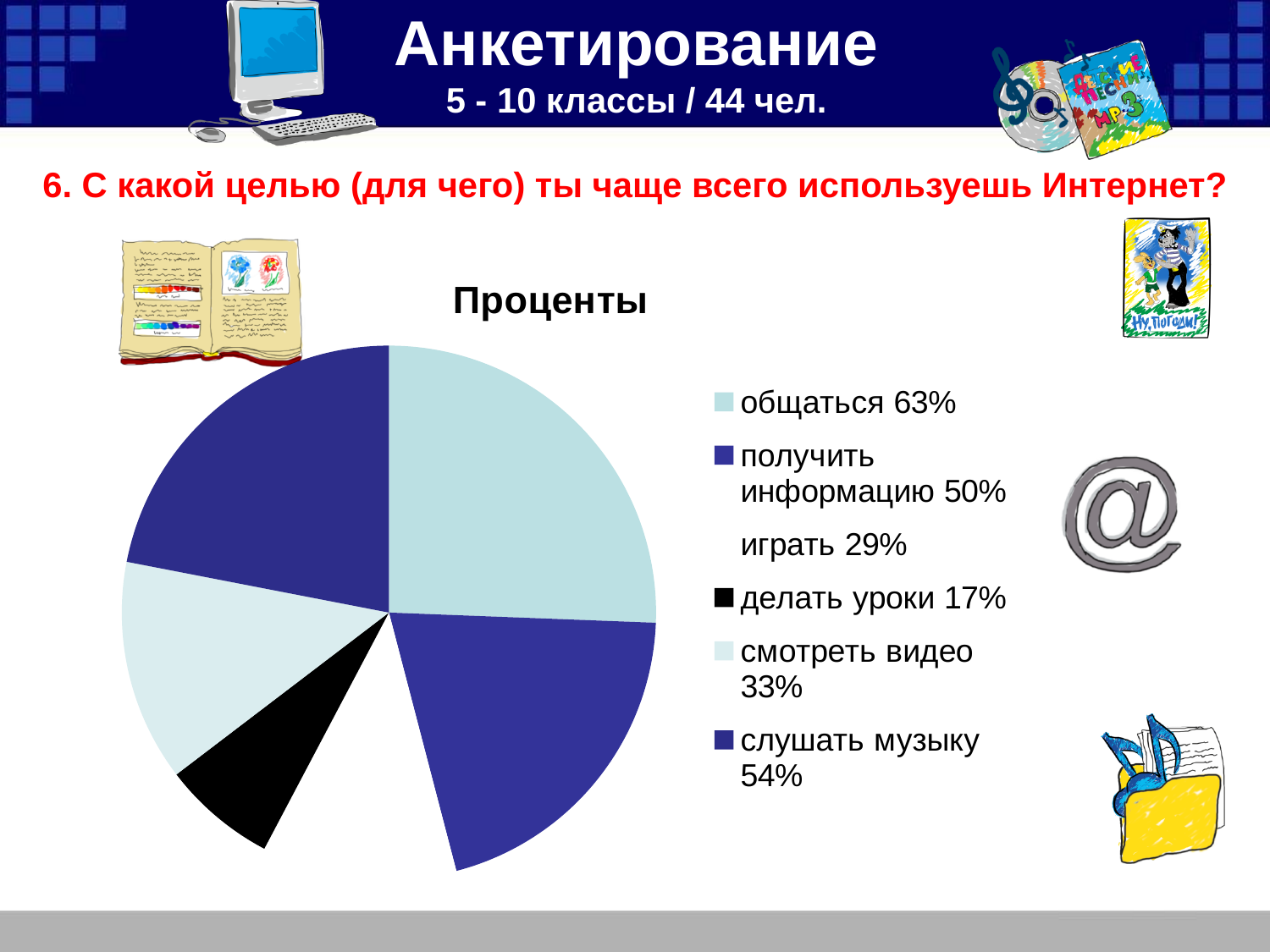
What percentage is shown for "играть"? 29% Which is larger, the percentage for "слушать музыку" or for "смотреть видео"? слушать музыку What is the title of the chart? Проценты What percentage is shown for "делать уроки"? 17% What percentage is shown for "получить информацию"? 50% What percentage is shown for "смотреть видео"? 33% Which category has the lowest percentage? делать уроки How many categories does the pie chart's legend list? 6 What percentage is shown for "общаться"? 63% What percentage is shown for "слушать музыку"? 54% Which category has the highest percentage? общаться What kind of chart is shown on the slide? pie chart